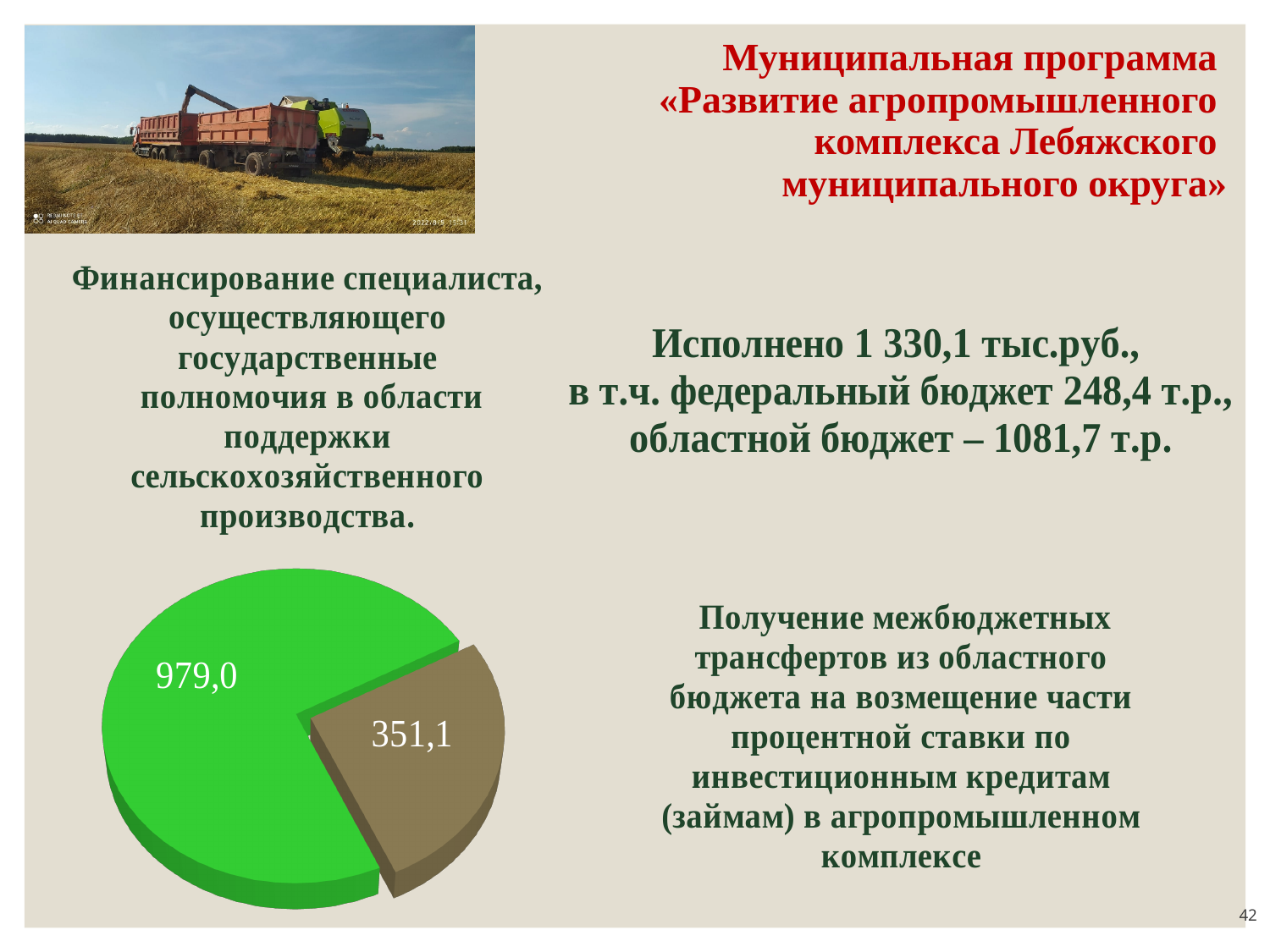
What share of the pie does the green slice (979,0) represent? 73.6% What share of the pie does the brown slice (351,1) represent? 26.4% What value is printed on the brown slice of the pie chart? 351,1 What is the total of the two values shown in the pie chart? 1330,1 What value is printed on the green slice of the pie chart? 979,0 How many slices does the pie chart have? 2 Which slice of the pie chart is the smallest? the brown slice (351,1) What kind of chart is shown on the slide? pie chart Which is larger in the pie chart, the green slice or the brown slice? the green slice Which slice of the pie chart is the largest? the green slice (979,0) What is the difference between the green slice value and the brown slice value in the pie chart? 627,9 What two colours are used for the slices of the pie chart? green and brown